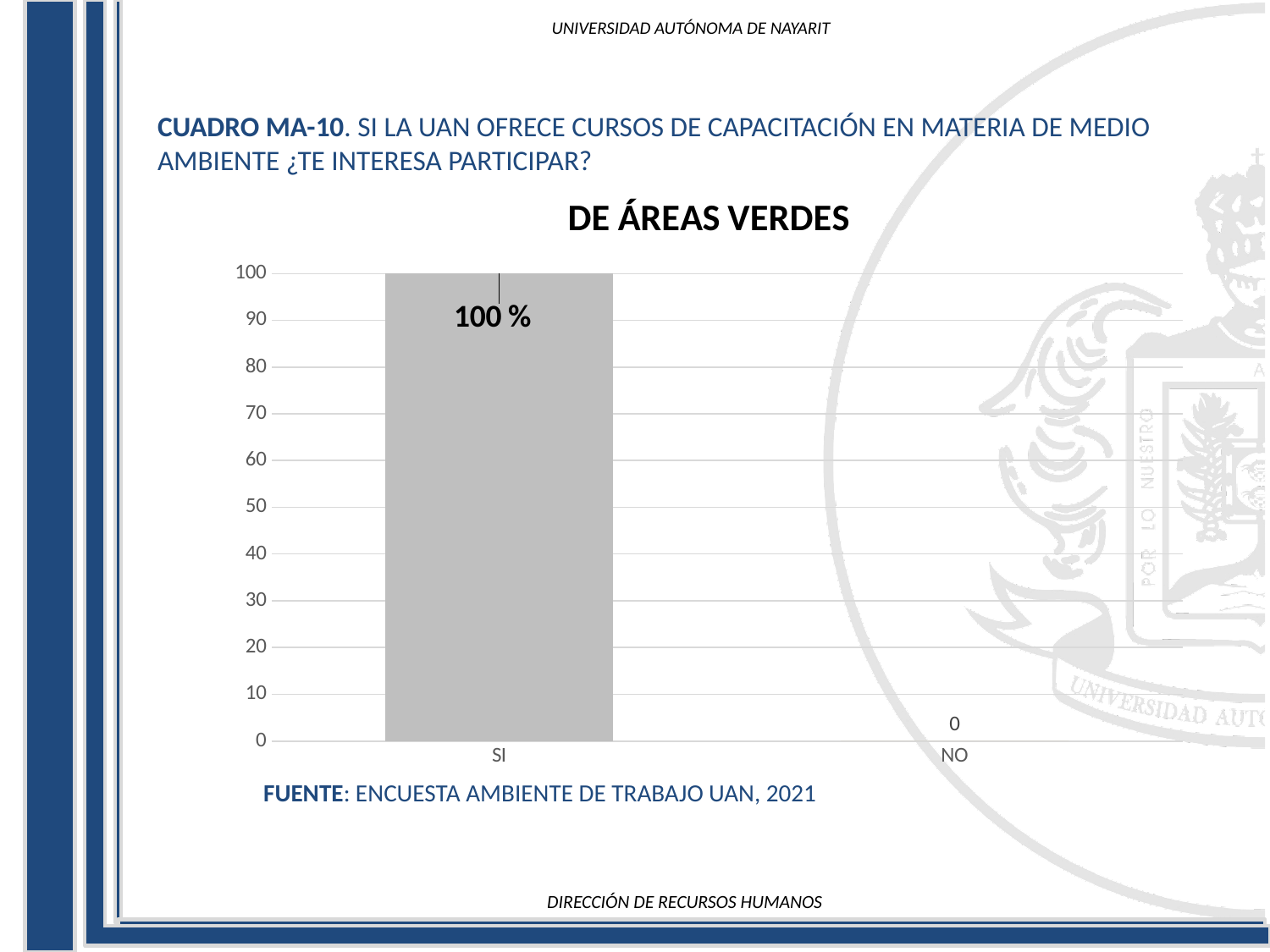
What kind of chart is shown on the slide? bar chart What is the highest value shown on the y axis? 100 What is the source cited below the chart? ENCUESTA AMBIENTE DE TRABAJO UAN, 2021 Which category has the lowest value? NO What is the title of the chart? DE ÁREAS VERDES What is the value shown for the SI category? 100 % Is the value for SI greater or less than 50? greater What is the value shown for the NO category? 0 Which category has the highest value? SI How many categories are shown on the x axis? 2 Which is larger, the value for SI or the value for NO? SI